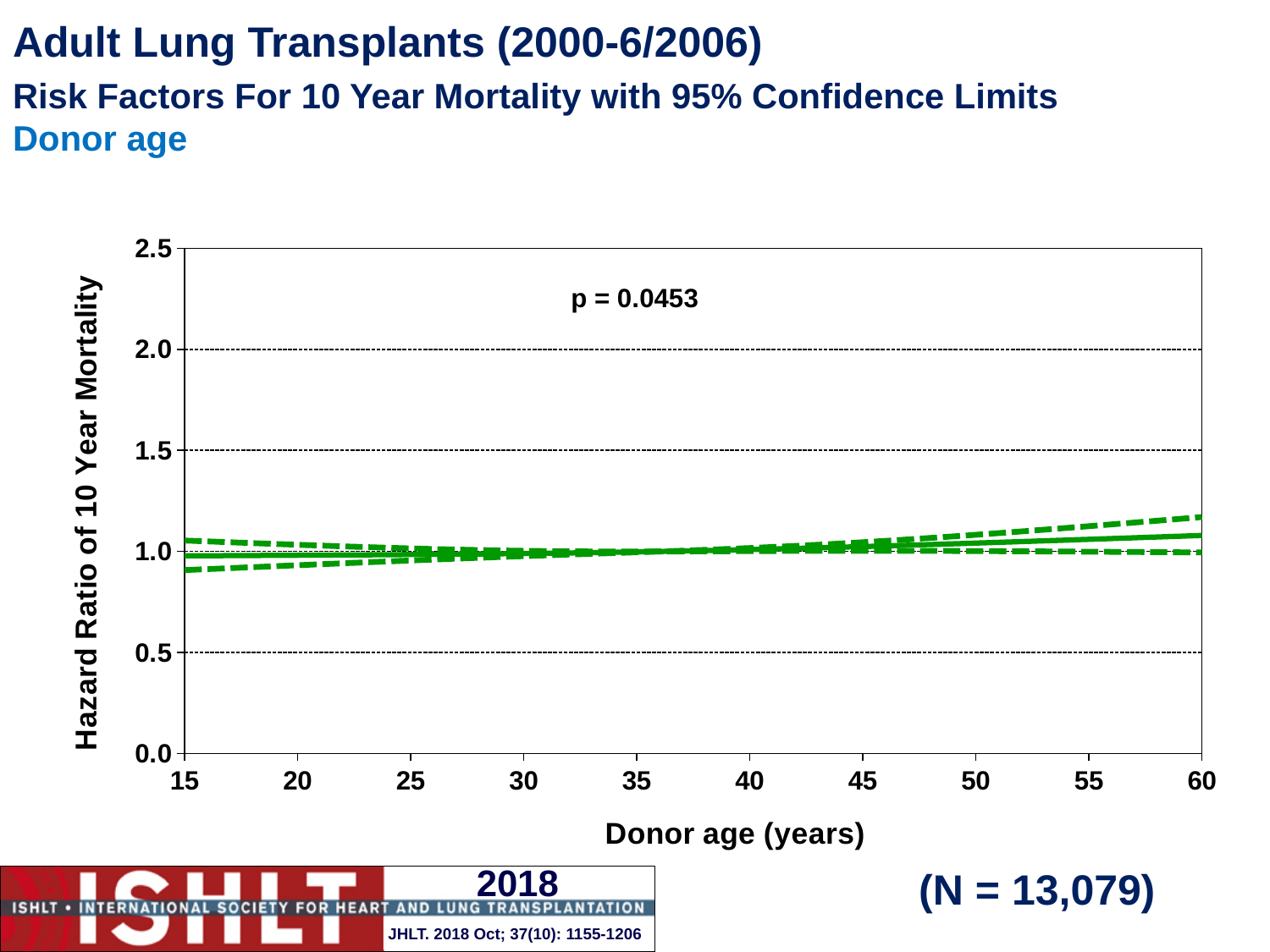
What is the highest value shown on the y axis? 2.5 How many lines are plotted on the chart? 3 Is the hazard ratio at donor age 60 greater or less than 1.0? greater What is the label of the x axis? Donor age (years) What is the p-value shown on the chart? p = 0.0453 Does the solid hazard ratio line rise or fall as donor age increases from 15 to 60 years? rises Is the hazard ratio at donor age 15 greater or less than 0.5? greater Is the lower 95% confidence limit at donor age 15 greater or less than 0.5? greater What is the sample size (N) shown on the slide? N = 13,079 What type of chart is shown on the slide? line chart